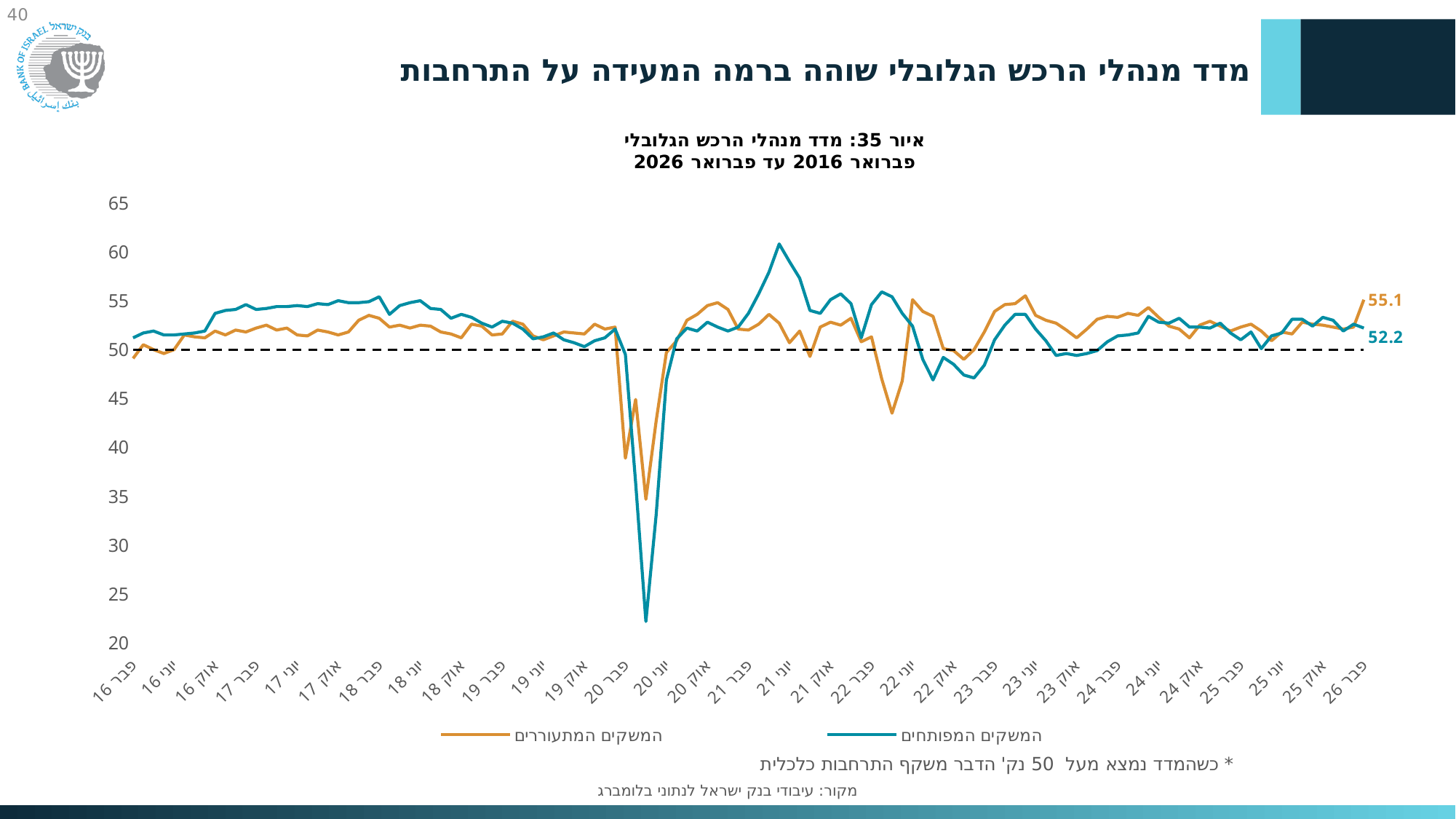
What kind of chart is shown on the slide? line chart How many series does the legend list? 2 At the end of the series (פבר 26), which series has the higher value, המשקים המתעוררים or המשקים המפותחים? המשקים המתעוררים Is the peak of the המשקים המפותחים line in 2021 greater or less than 55? greater Which series reaches the lowest point on the chart? המשקים המפותחים Which series reaches the highest point on the chart? המשקים המפותחים What is the value labelled at the end of the המשקים המתעוררים (emerging markets) line? 55.1 Is the lowest value of the המשקים המתעוררים line (around 2020) greater or less than 40? less Is the lowest value of the המשקים המפותחים line (around 2020) greater or less than 30? less What is the value labelled at the end of the המשקים המפותחים (developed markets) line? 52.2 At what level is the dashed horizontal reference line drawn? 50 What is the difference between the final labelled values of המשקים המתעוררים (55.1) and המשקים המפותחים (52.2)? 2.9